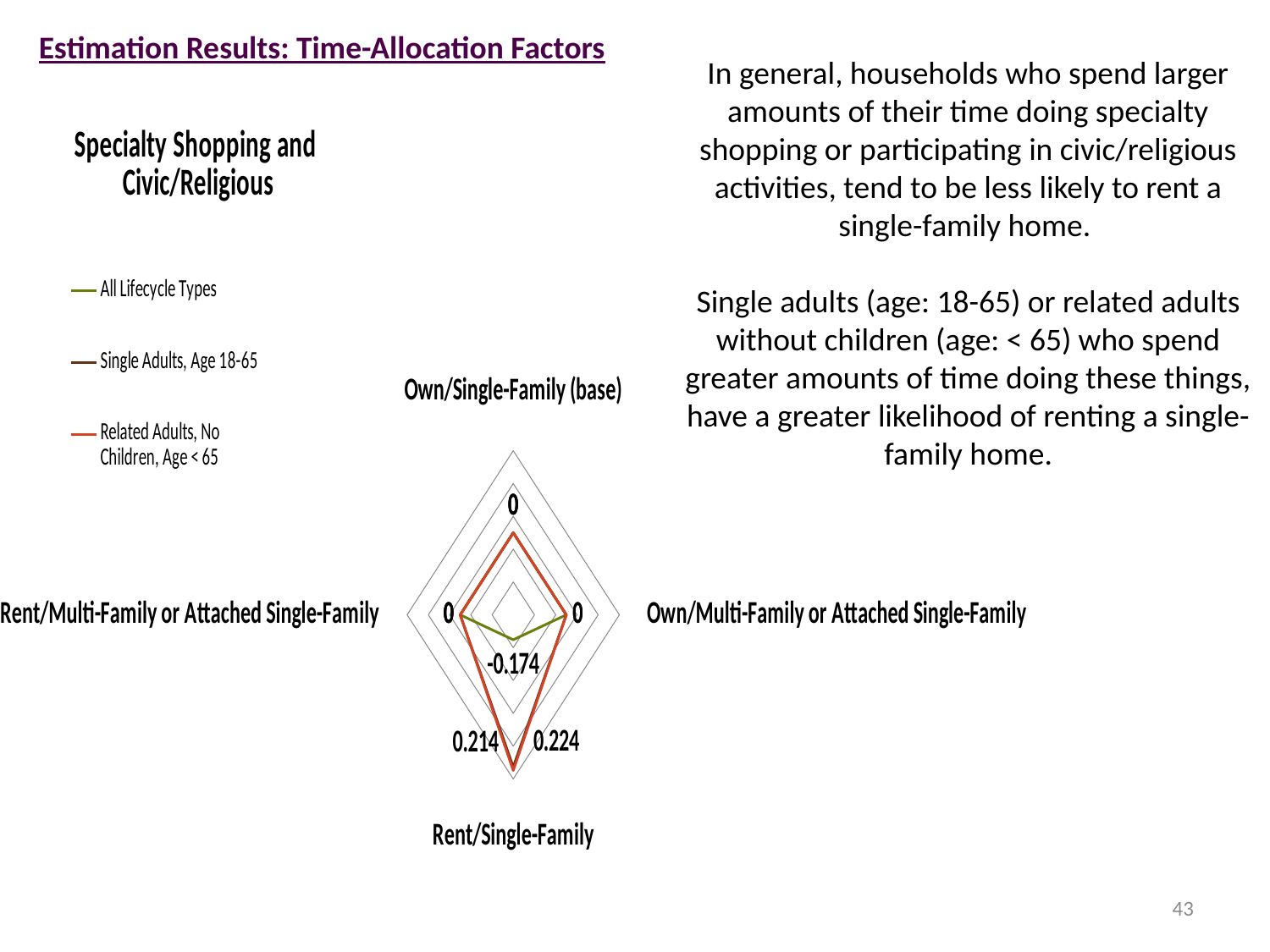
Is the value for All Lifecycle Types on the Rent/Single-Family axis greater or less than 0? less Which housing category is labeled as the base in the chart? Own/Single-Family (base) What is the difference between the two positive values labeled on the Rent/Single-Family axis (0.224 and 0.214)? 0.01 What is the title of the chart? Specialty Shopping and Civic/Religious Which axis carries the largest labeled value in the chart? Rent/Single-Family What is the value for All Lifecycle Types on the Rent/Single-Family axis? -0.174 How many axes (housing categories) does the radar chart have? 4 What value is labeled on the Own/Single-Family (base) axis? 0 What value is labeled on the Own/Multi-Family or Attached Single-Family axis? 0 What kind of chart is shown on the slide? Radar chart How many series does the chart's legend list? 3 Is the value for Related Adults, No Children, Age < 65 on the Rent/Single-Family axis greater or less than 0? greater